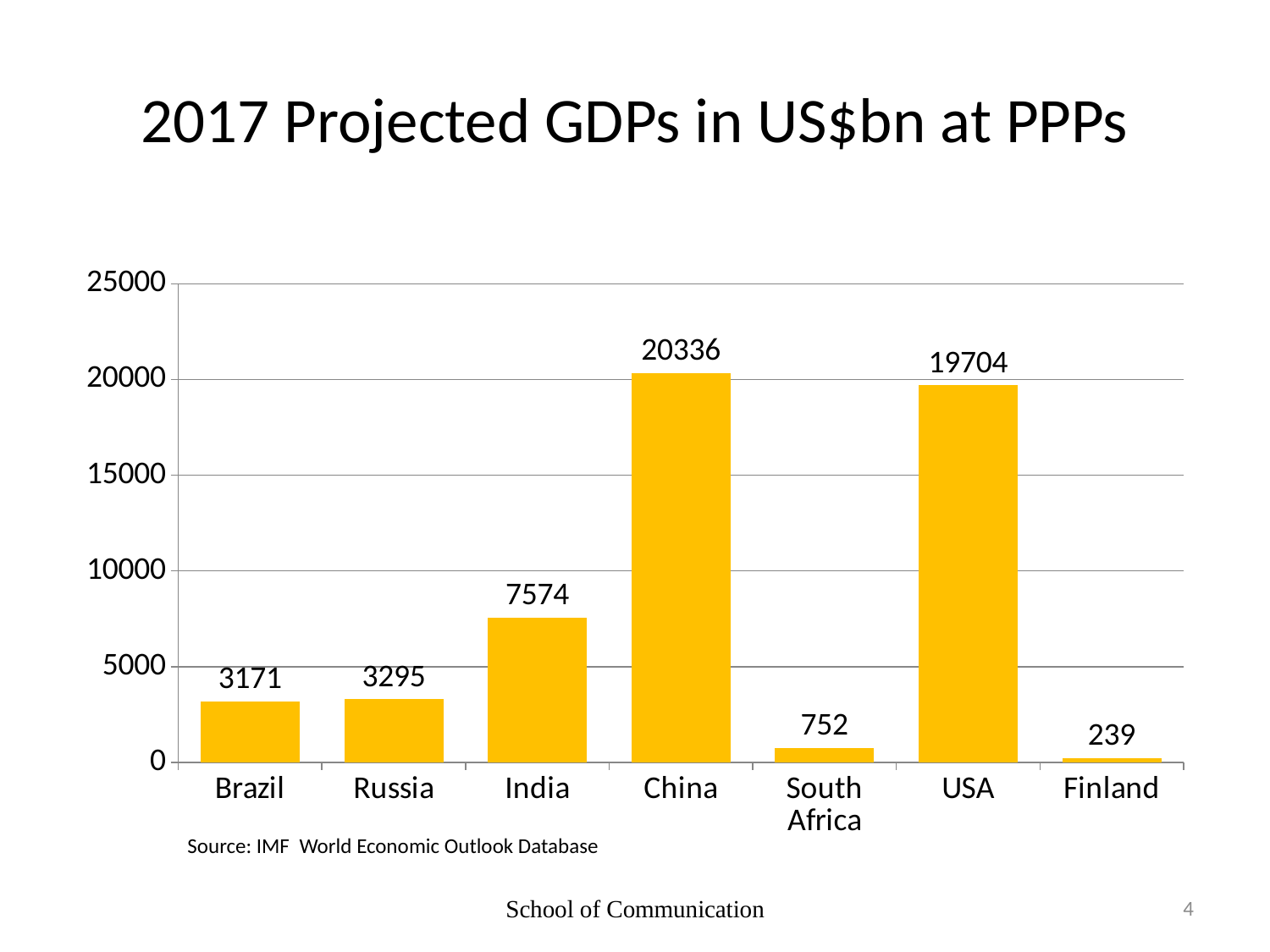
What is the projected 2017 GDP for China? 20336 What kind of chart is shown on the slide? Bar chart What is the projected 2017 GDP for South Africa? 752 Which country has the highest projected GDP on the chart? China What is the difference between the projected GDPs of China and the USA? 632 Which has a larger projected GDP, India or Russia? India Is the value for the USA greater or less than 15000? greater What is the projected 2017 GDP for India? 7574 What source is cited for the chart data? IMF World Economic Outlook Database What is the difference between the projected GDPs of Russia and Brazil? 124 How many countries are shown on the chart? 7 Which country has the lowest projected GDP on the chart? Finland